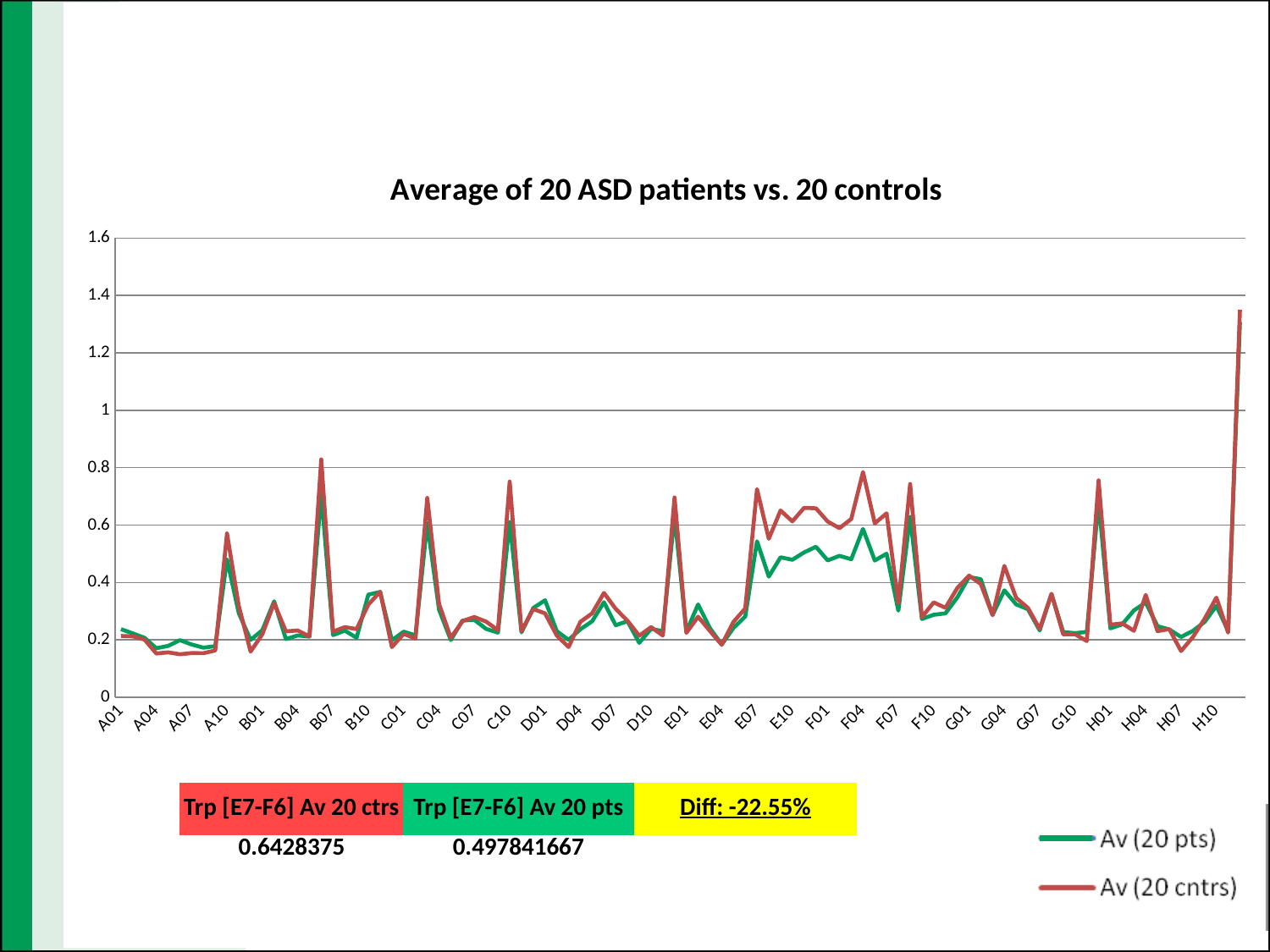
Is the value for Av (20 pts) at F04 greater or less than 0.8? less How many series does the legend list? 2 At F01, which series has the higher value, Av (20 pts) or Av (20 cntrs)? Av (20 cntrs) Is the value for Av (20 cntrs) at F04 greater or less than 0.6? greater Is the value for Av (20 pts) at A01 greater or less than 0.4? less How many category labels are printed along the x axis? 32 At E10, which series has the higher value, Av (20 pts) or Av (20 cntrs)? Av (20 cntrs) What type of chart is shown on the slide? Line chart Which series is drawn in green? Av (20 pts) What is the title of the chart? Average of 20 ASD patients vs. 20 controls